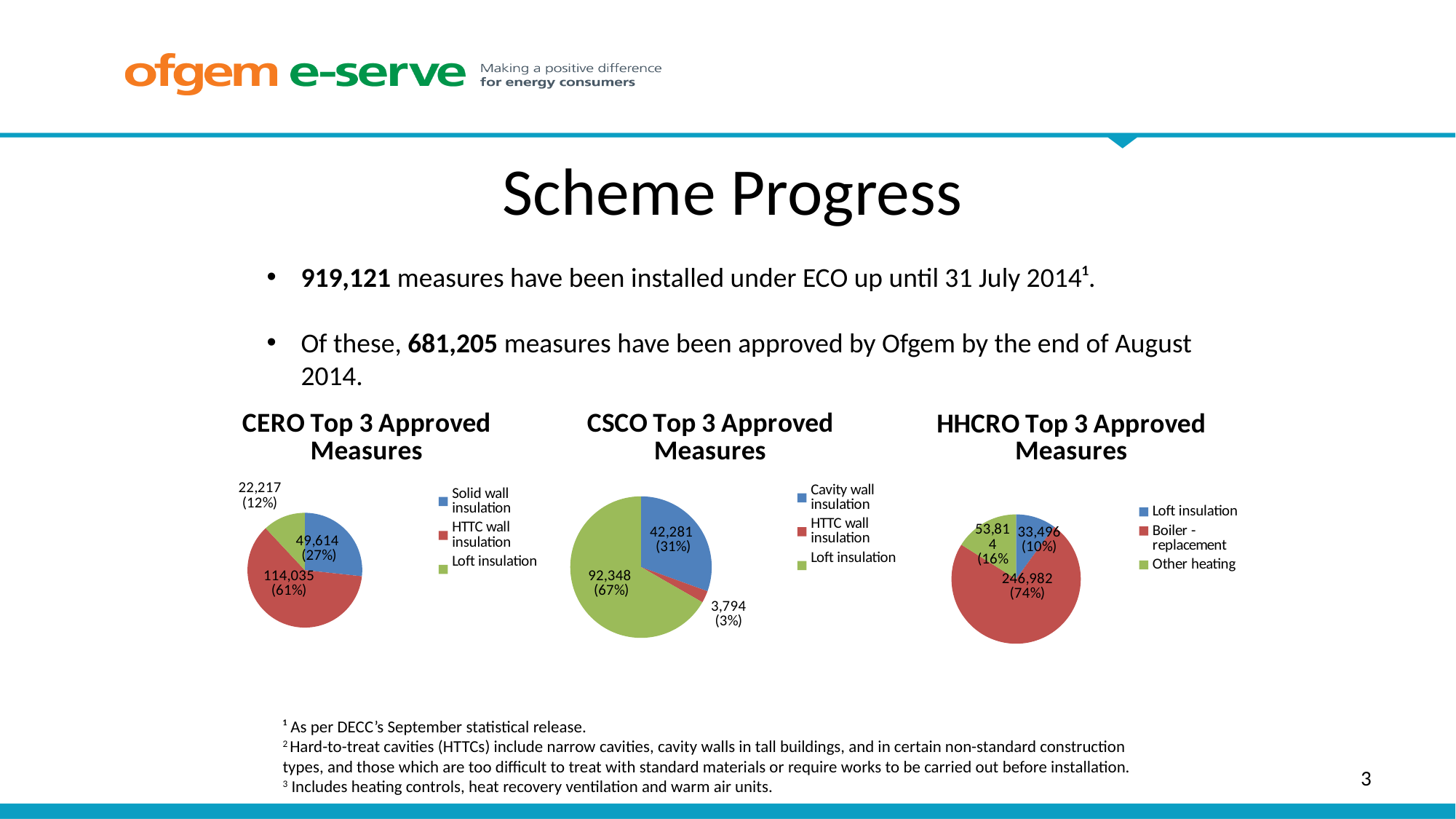
In the CSCO Top 3 Approved Measures chart, what is the value for Loft insulation? 92,348 What type of chart is the HHCRO Top 3 Approved Measures chart? Pie chart How many slices does the CSCO Top 3 Approved Measures chart have? 3 In the HHCRO Top 3 Approved Measures chart, what is the value for Boiler replacement? 246,982 In the CERO Top 3 Approved Measures chart, which measure has the largest slice? HTTC wall insulation In the HHCRO Top 3 Approved Measures chart, which is larger, Loft insulation or Other heating? Other heating In the CSCO Top 3 Approved Measures chart, which measure has the smallest slice? HTTC wall insulation In the HHCRO Top 3 Approved Measures chart, what share of the pie is Other heating? 16% In the CERO Top 3 Approved Measures chart, what share of the pie is Loft insulation? 12% In the CSCO Top 3 Approved Measures chart, what share of the pie is Cavity wall insulation? 31% In the CERO Top 3 Approved Measures chart, what is the value for HTTC wall insulation? 114,035 In the CERO Top 3 Approved Measures chart, what is the difference between HTTC wall insulation and Solid wall insulation? 64,421